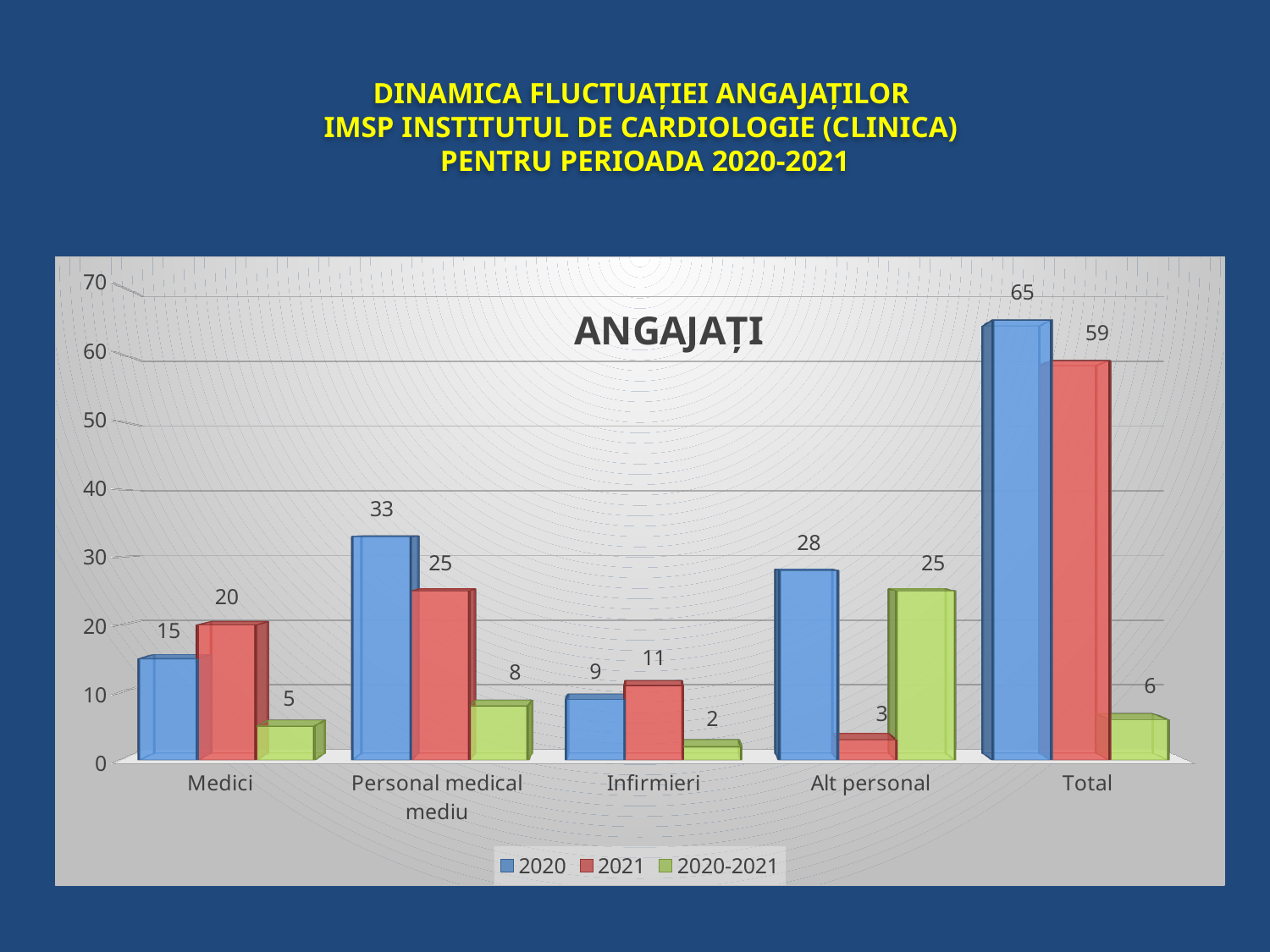
How many series does the legend list? 3 What kind of chart is shown on the slide? Bar chart Which is larger for Alt personal: the 2020 value or the 2021 value? 2020 What is the value for Total in the 2021 series? 59 What is the value for Personal medical mediu in the 2021 series? 25 How many categories are shown on the x axis? 5 Which category has the lowest value in the 2020-2021 series? Infirmieri What is the value for Medici in the 2020 series? 15 What is the value for Alt personal in the 2020-2021 series? 25 What is the title shown inside the chart area? ANGAJAȚI What is the difference between the 2020 and 2021 values for Total? 6 Which category has the highest value in the 2020 series? Total